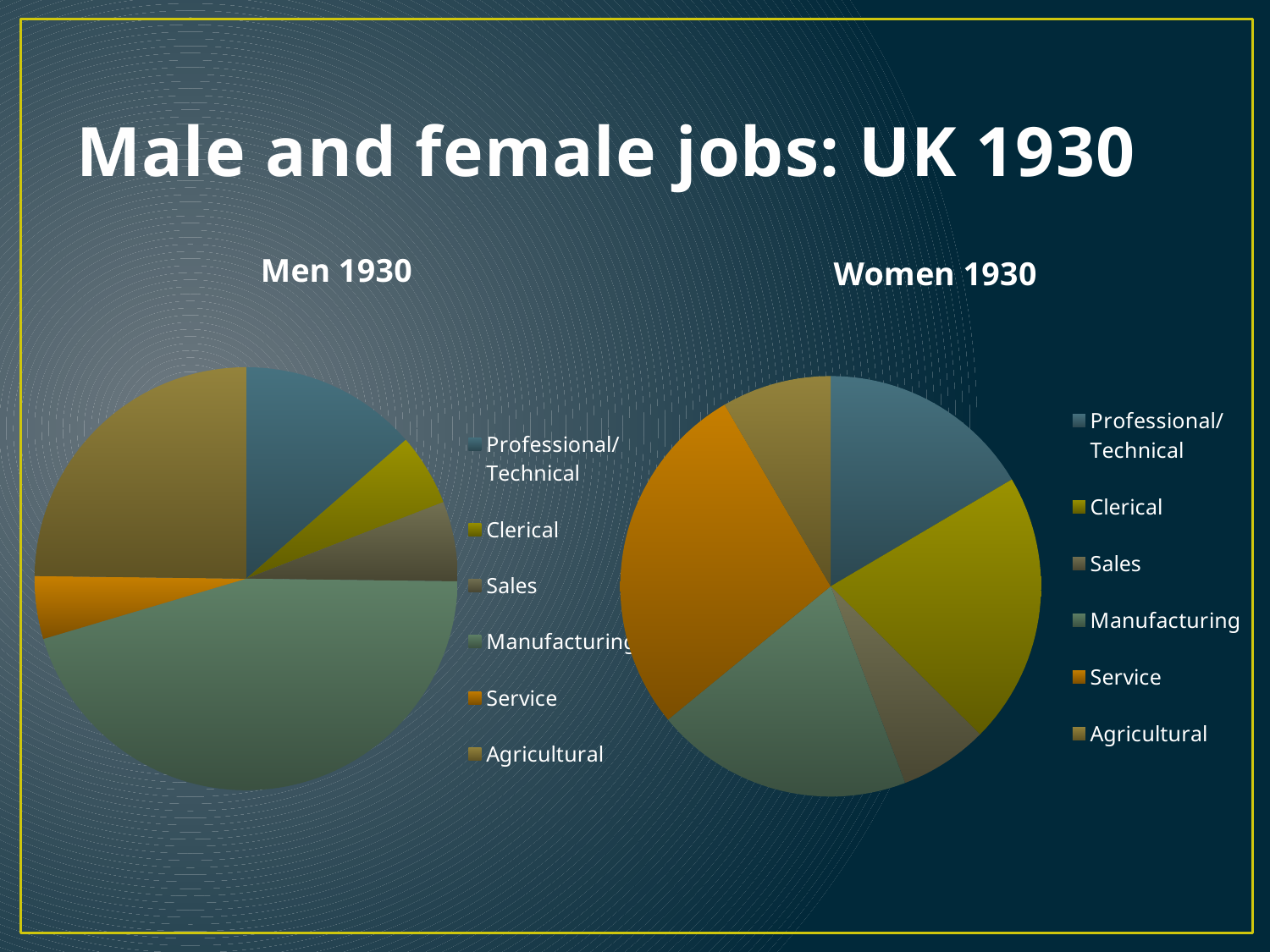
What kind of chart is the Women 1930 chart? pie chart What is the title of the pie chart on the right of the slide? Women 1930 How many categories does the legend of the Women 1930 chart list? 6 In the Women 1930 chart, which slice is larger, Service or Sales? Service How many slices does the Men 1930 pie chart have? 6 In the Men 1930 chart, which slice is larger, Manufacturing or Agricultural? Manufacturing What kind of chart is the Men 1930 chart? pie chart In the Women 1930 chart, which slice is larger, Clerical or Agricultural? Clerical What is the title of the slide? Male and female jobs: UK 1930 In the Women 1930 chart, which category has the largest slice? Service In the Men 1930 chart, which category has the largest slice? Manufacturing